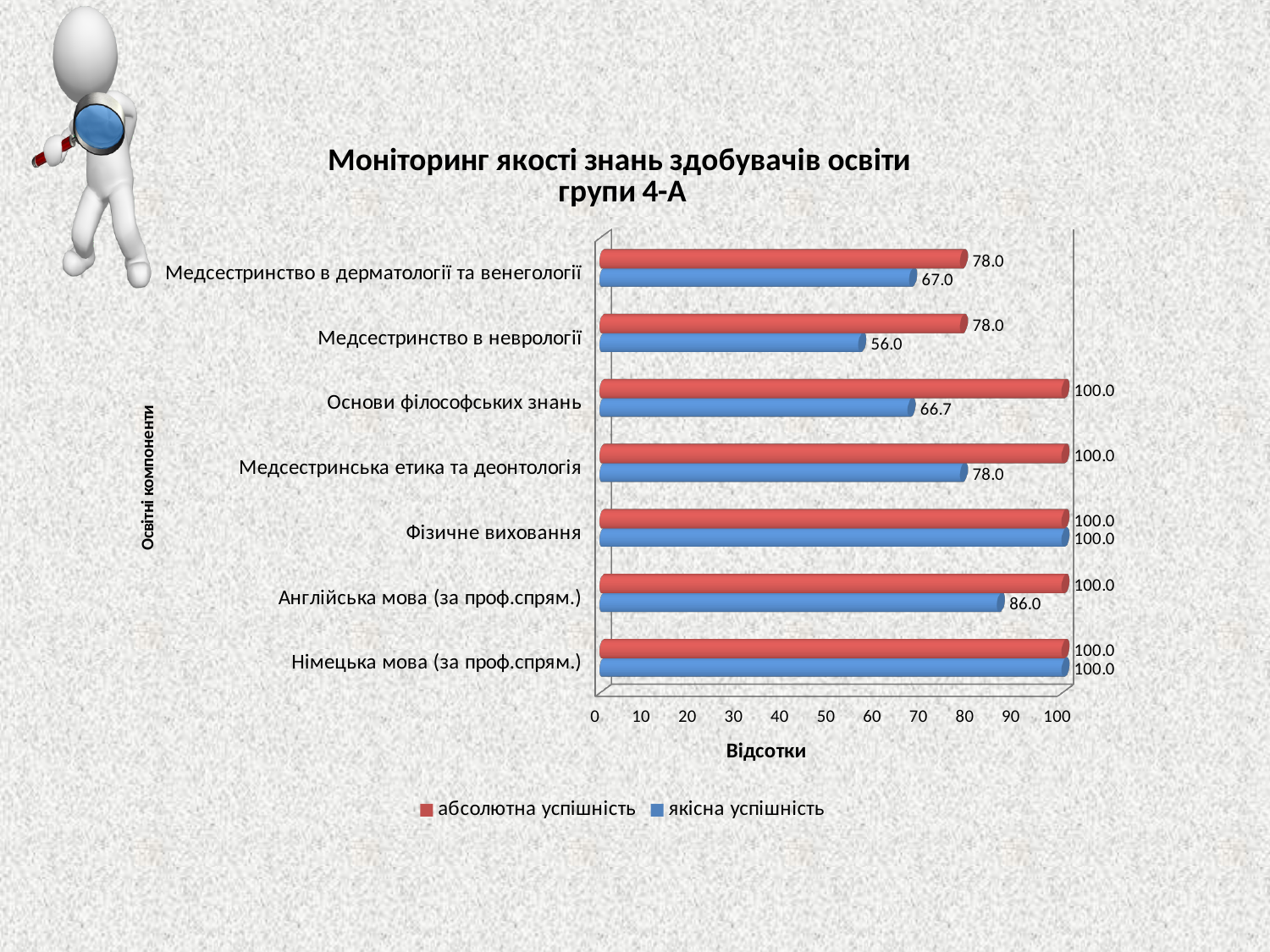
What is the difference between абсолютна успішність and якісна успішність for Медсестринська етика та деонтологія? 22.0 Which is larger: якісна успішність for Англійська мова (за проф.спрям.) or for Основи філософських знань? Англійська мова (за проф.спрям.) How many categories (освітні компоненти) are shown on the chart? 7 What is the value of якісна успішність for Основи філософських знань? 66.7 What is the difference between якісна успішність for Медсестринство в дерматології та венегології and for Медсестринство в неврології? 11.0 Which category has the lowest value of якісна успішність? Медсестринство в неврології What kind of chart is shown on the slide? Bar chart How many series does the legend list? 2 What is the value of якісна успішність for Медсестринство в неврології? 56.0 What is the title of the chart? Моніторинг якості знань здобувачів освіти групи 4-А What is the value of абсолютна успішність for Медсестринство в дерматології та венегології? 78.0 What is the value of якісна успішність for Англійська мова (за проф.спрям.)? 86.0